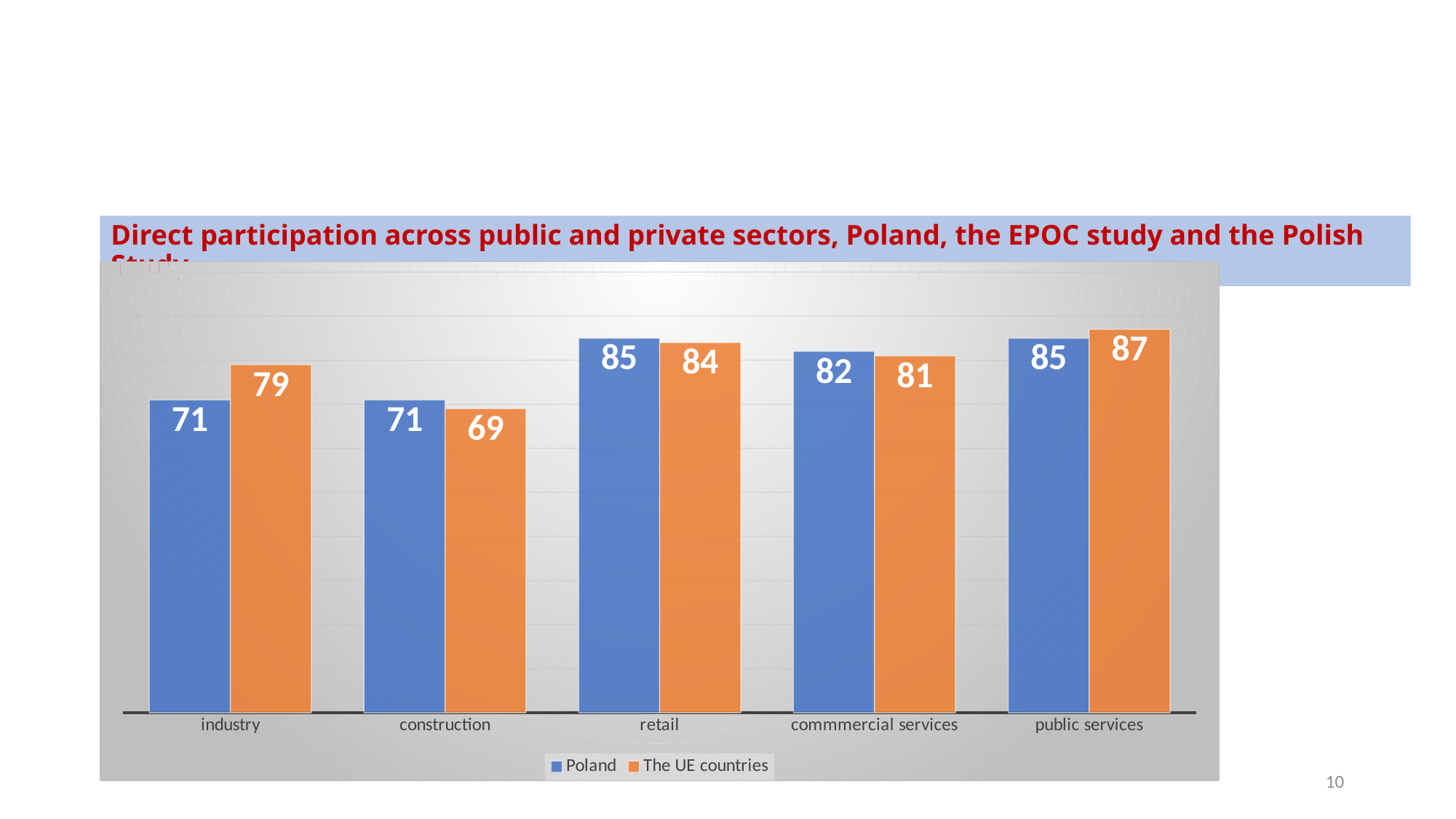
What is the value for Poland in the commmercial services category? 82 How many categories are shown on the x axis? 5 Which category has the lowest value for The UE countries? construction What is the difference between The UE countries and Poland values in the industry category? 8 What is the value for The UE countries in the industry category? 79 Which category has the highest value for The UE countries? public services What kind of chart is shown on the slide? bar chart What is the value for The UE countries in the construction category? 69 Which is larger in the public services category: Poland or The UE countries? The UE countries Which colour represents Poland in the chart? blue What is the value for Poland in the retail category? 85 How many series does the legend list? 2